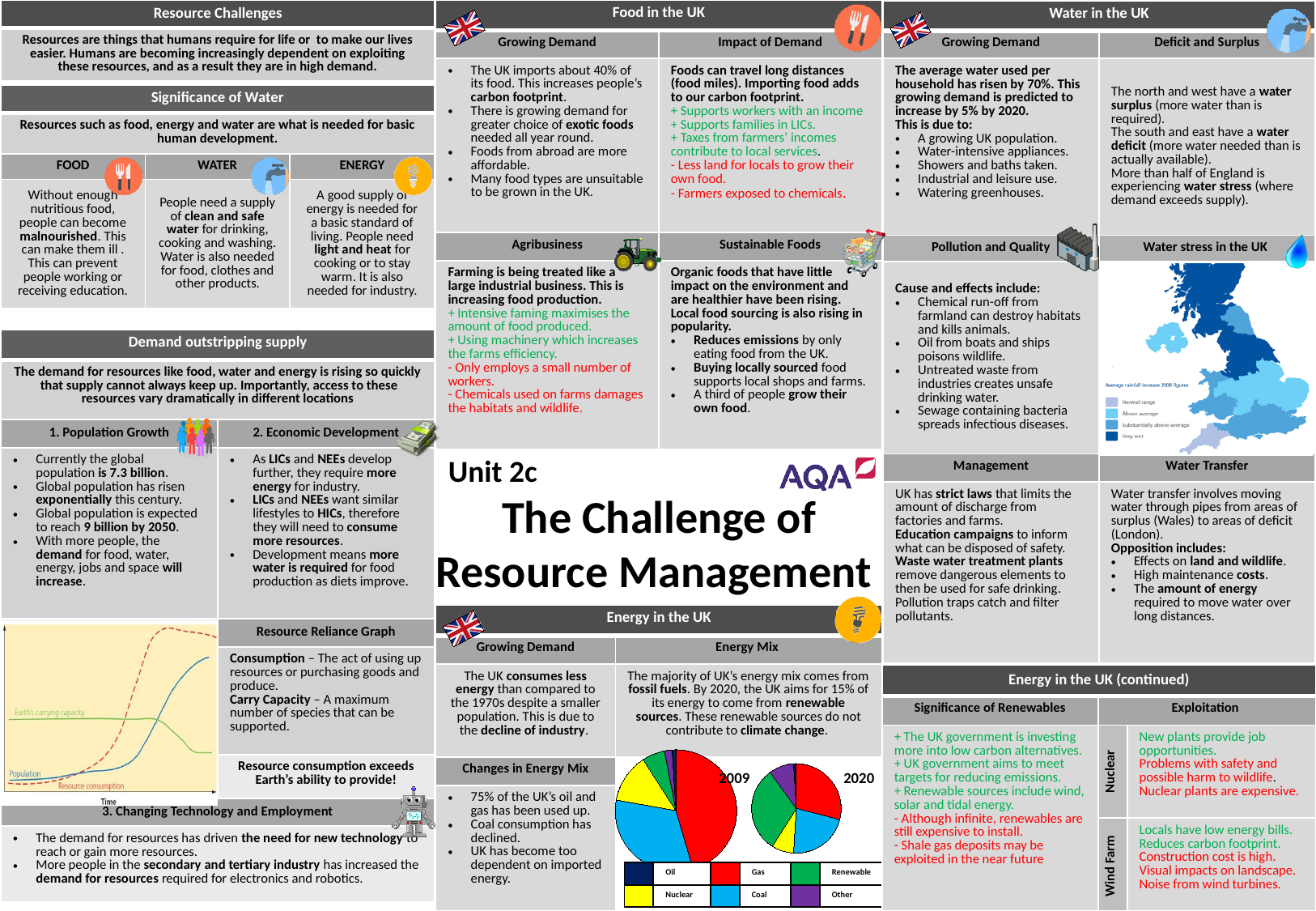
What kind of charts are used to show the UK energy mix in the Energy in the UK section? pie charts How many pie charts are shown in the Energy Mix section? 2 What kind of chart is the Resource Reliance Graph on the left of the slide? line chart Which two years are shown by the energy mix pie charts? 2009 and 2020 In the energy mix pie charts, is the Nuclear slice larger in 2009 or in 2020? 2009 On the Resource Reliance Graph, does the Population line rise or fall over time? rise In the energy mix pie charts, is the Renewable slice larger in 2009 or in 2020? 2020 On the Resource Reliance Graph, what is the label of the horizontal axis? Time How many energy sources does the legend of the energy mix pie charts list? 6 How many lines are plotted on the Resource Reliance Graph? 3 On the Resource Reliance Graph, which line is drawn as a dashed line? Resource consumption